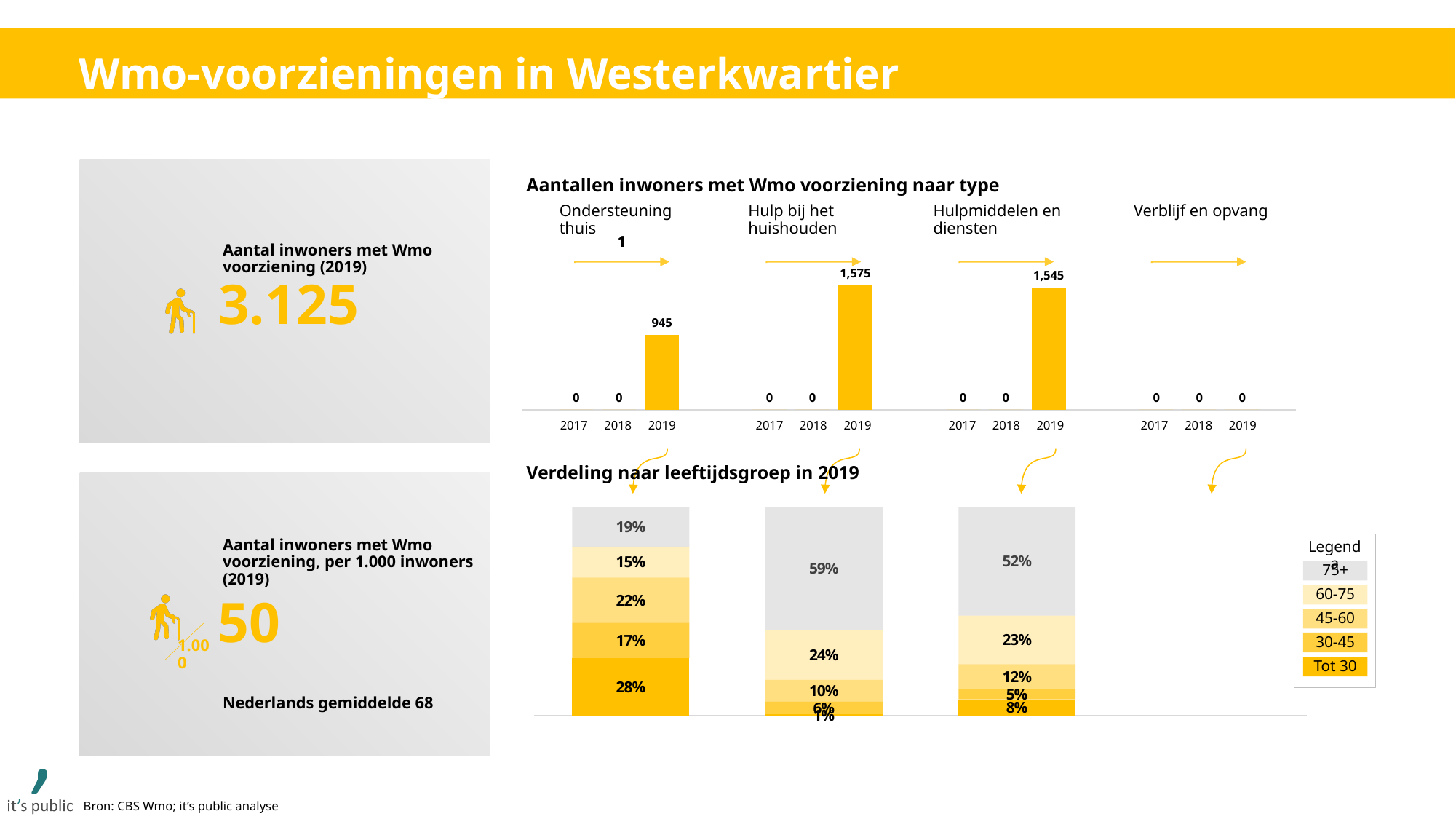
In the chart 'Verdeling naar leeftijdsgroep in 2019', which age group has the largest share for Hulpmiddelen en diensten? 75+ In the chart 'Verdeling naar leeftijdsgroep in 2019', what is the share of the 75+ age group for Hulp bij het huishouden? 59% In the chart 'Aantallen inwoners met Wmo voorziening naar type', which type has the highest value in 2019? Hulp bij het huishouden In the chart 'Verdeling naar leeftijdsgroep in 2019', what is the share of the Tot 30 age group for Ondersteuning thuis? 28% In the chart 'Aantallen inwoners met Wmo voorziening naar type', what is the difference between the 2019 values for Hulp bij het huishouden and Hulpmiddelen en diensten? 30 What kind of chart is 'Verdeling naar leeftijdsgroep in 2019'? Stacked bar chart In the chart 'Aantallen inwoners met Wmo voorziening naar type', what is the value for Verblijf en opvang in 2019? 0 In the chart 'Aantallen inwoners met Wmo voorziening naar type', what is the value for Hulp bij het huishouden in 2019? 1,575 In the chart 'Aantallen inwoners met Wmo voorziening naar type', how many years are shown on the x axis for each type? 3 In the chart 'Aantallen inwoners met Wmo voorziening naar type', what is the value for Ondersteuning thuis in 2019? 945 In the chart 'Verdeling naar leeftijdsgroep in 2019', how many age groups does the legend list? 5 In the chart 'Aantallen inwoners met Wmo voorziening naar type', which is larger in 2019: Ondersteuning thuis or Hulpmiddelen en diensten? Hulpmiddelen en diensten